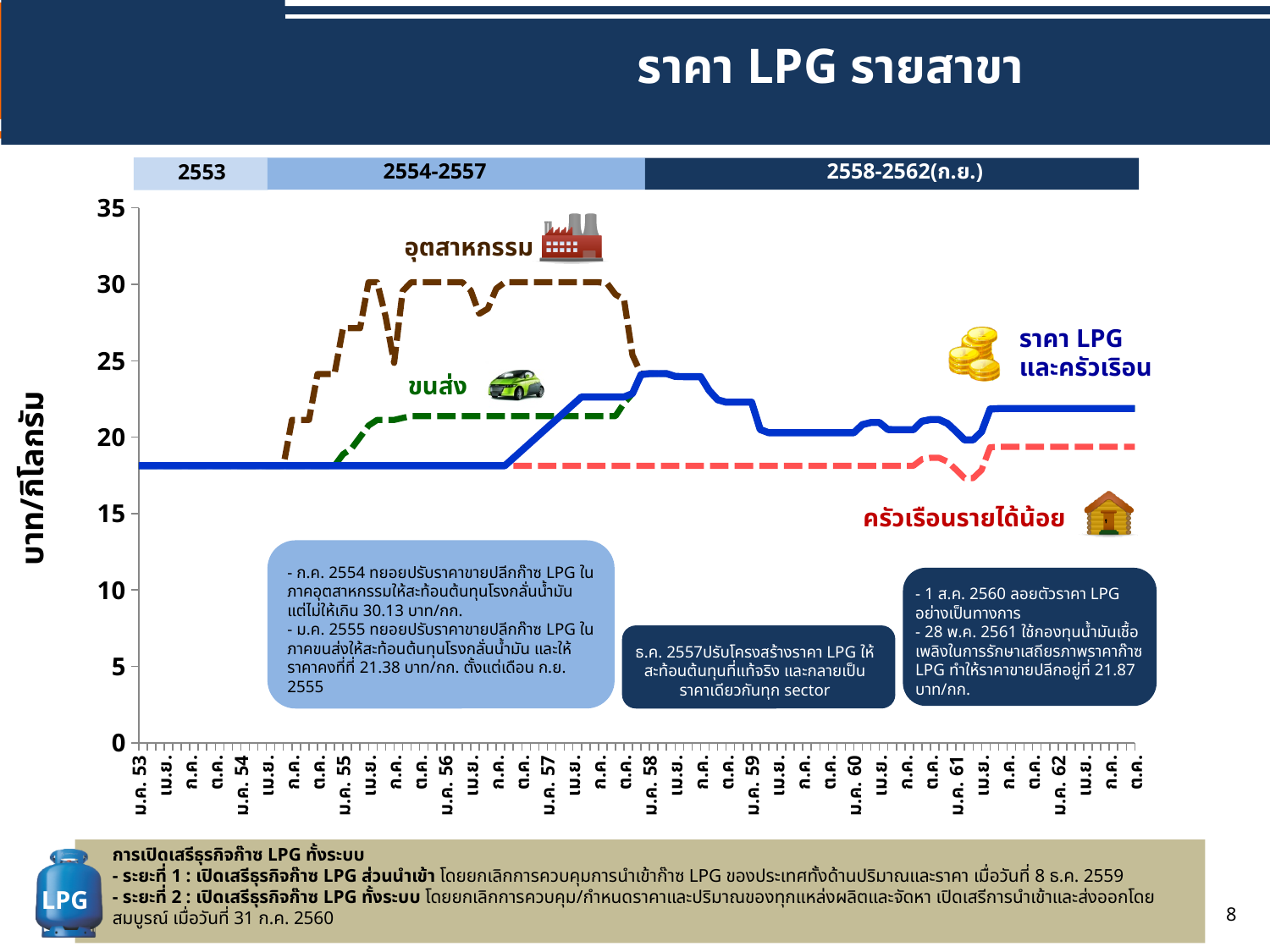
What is the label of the vertical axis? บาท/กิโลกรัม What kind of chart is shown on the slide? line chart Is the value of the ครัวเรือนรายได้น้อย line in ม.ค. 58 greater or less than 20? less Is the peak value of the อุตสาหกรรม line greater or less than 25? greater Is the value of the ราคา LPG และครัวเรือน line in ม.ค. 53 greater or less than 20? less Which sector has the highest LPG price during 2555-2557? อุตสาหกรรม Which line is the lowest at the end of the chart (ก.ย. 62)? ครัวเรือนรายได้น้อย What is the title of the chart? ราคา LPG รายสาขา How many price series (lines) are plotted on the chart? 4 In ม.ค. 56, which line is higher: อุตสาหกรรม or ขนส่ง? อุตสาหกรรม Does the ราคา LPG และครัวเรือน line rise or fall between ม.ค. 57 and ม.ค. 58? rise